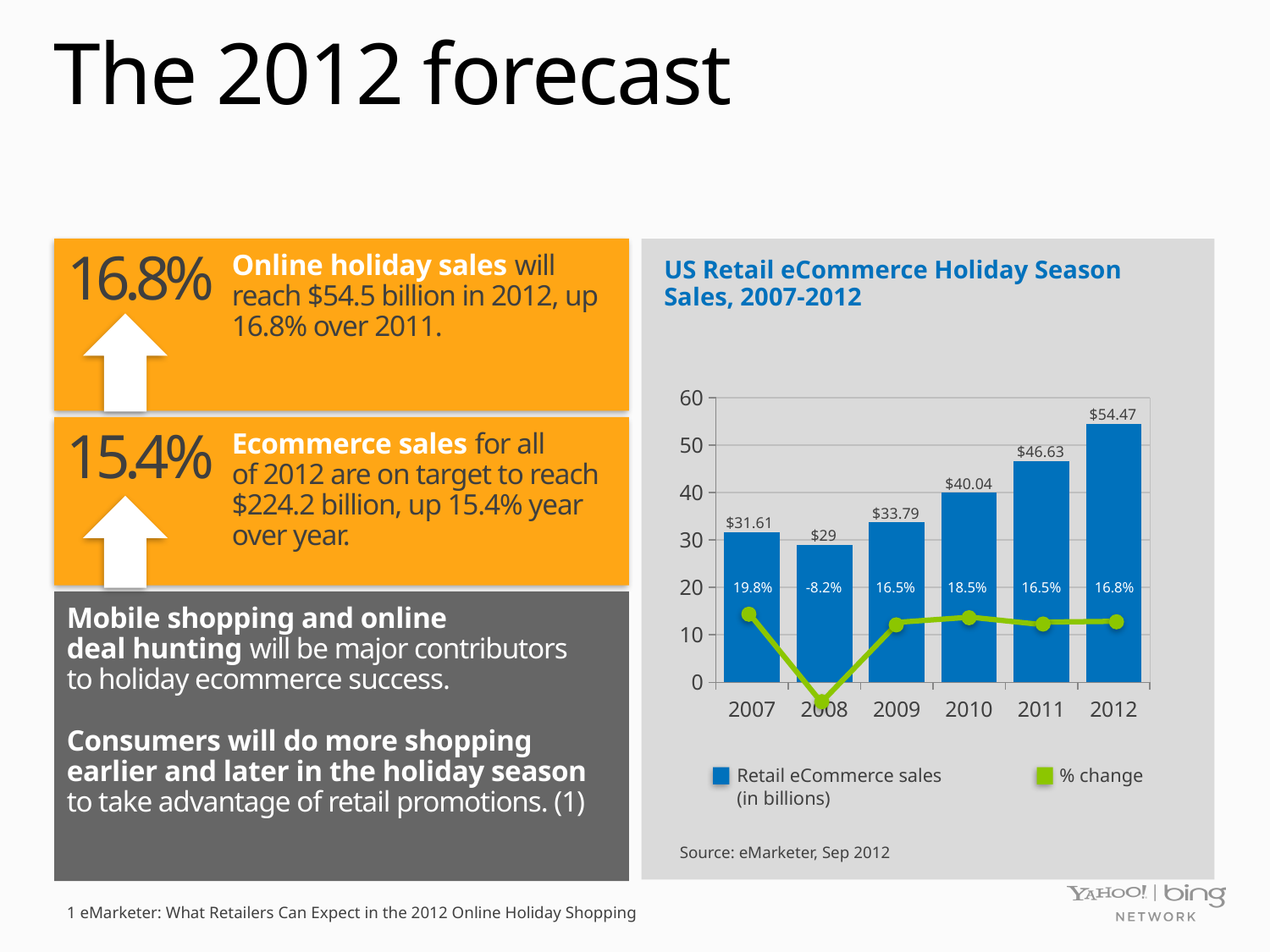
What is the % change value for 2008? -8.2% Which is larger, the Retail eCommerce sales for 2009 or for 2010? 2010 What is the Retail eCommerce sales value for 2012? $54.47 What is the difference in Retail eCommerce sales between 2012 and 2011? $7.84 What is the title of the chart? US Retail eCommerce Holiday Season Sales, 2007-2012 Which year has the lowest % change? 2008 What kind of chart is used to show Retail eCommerce sales? Bar chart Which year has the lowest Retail eCommerce sales? 2008 How many series does the chart legend list? 2 Which year has the highest Retail eCommerce sales? 2012 How many years are shown on the x axis of the chart? 6 What is the Retail eCommerce sales value for 2010? $40.04